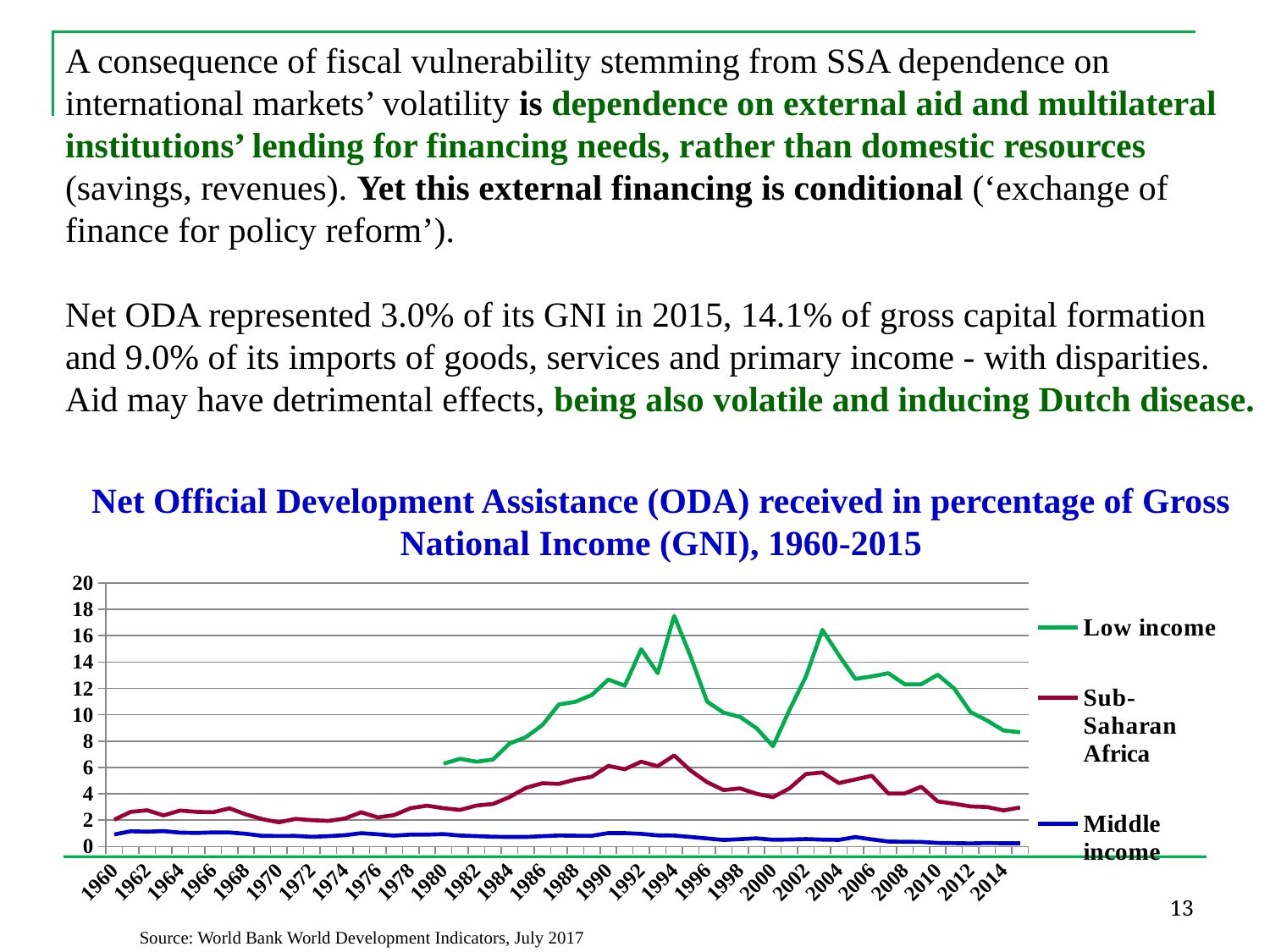
How many series does the chart's legend list? 3 Which series has the highest value in 2004? Low income Is the value for Low income in 2000 greater or less than 10? less Does the Low income series rise or fall between 2010 and 2014? Fall Is the value for Low income in 1994 greater or less than 16? greater What kind of chart is shown on the slide? Line chart Is the value for Sub-Saharan Africa in 1994 greater or less than 6? greater In 1994, which is larger: the value for Low income or the value for Sub-Saharan Africa? Low income What is the title of the chart? Net Official Development Assistance (ODA) received in percentage of Gross National Income (GNI), 1960-2015 Which series is drawn in green in the chart? Low income Which series has the lowest value in 2014? Middle income